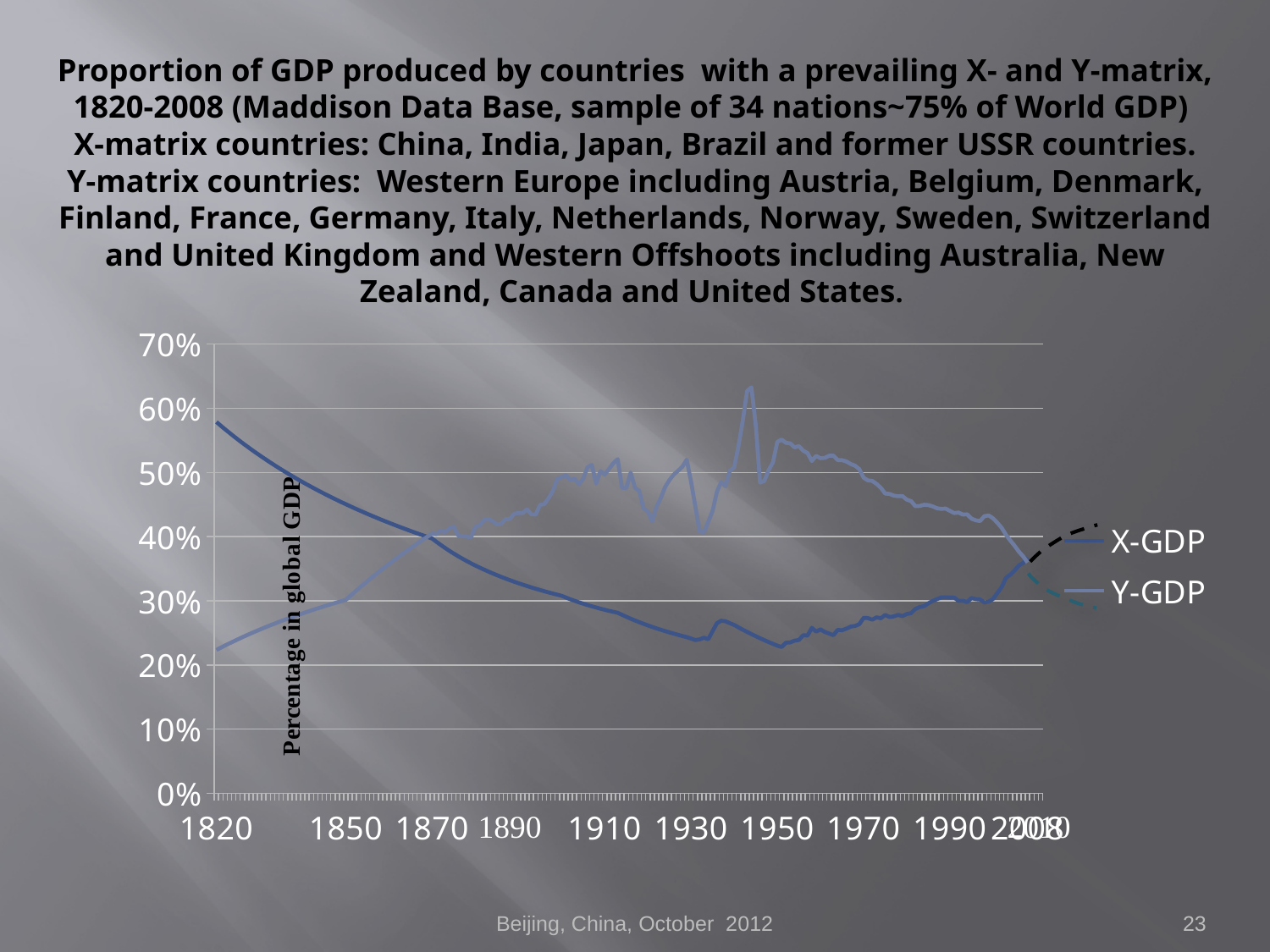
How many series does the legend list? 2 What kind of chart is shown on the slide? line chart Is the value for X-GDP in 1950 greater or less than 30%? less Is the peak value of Y-GDP greater or less than 60%? greater Does the Y-GDP line rise or fall between 1820 and 1900? rise Is the value for X-GDP in 1820 greater or less than 50%? greater Does the X-GDP line rise or fall between 1820 and 1950? fall In 1950, which series has the higher value, X-GDP or Y-GDP? Y-GDP What is the label on the vertical axis? Percentage in global GDP In 1820, which series has the higher value, X-GDP or Y-GDP? X-GDP What are the two series named in the legend? X-GDP and Y-GDP